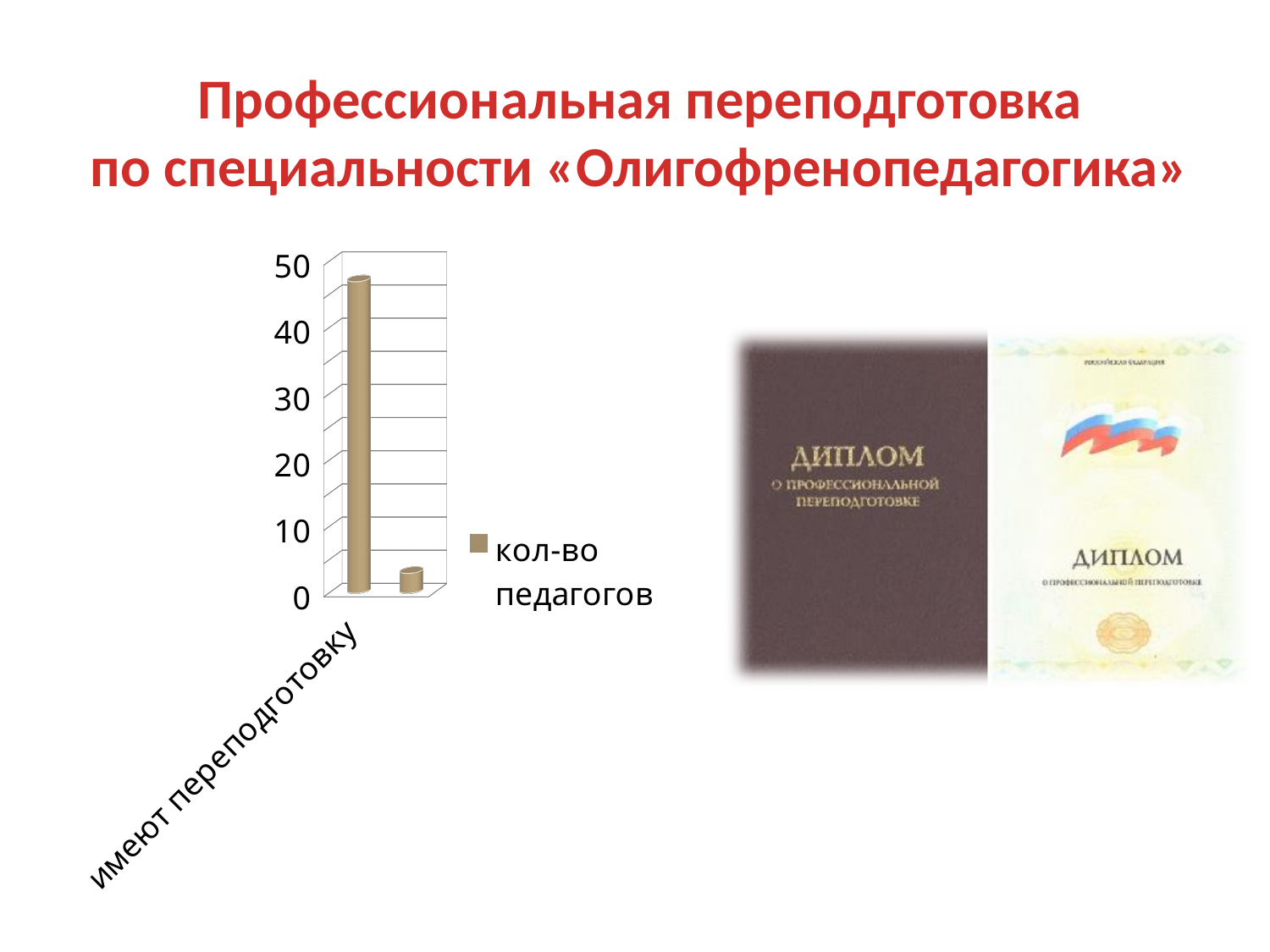
Which bar in the chart is the tallest? имеют переподготовку Is the value for "имеют переподготовку" greater or less than 40? greater How many series does the chart legend list? 1 How many bars are plotted in the chart? 2 What kind of chart is shown on the slide? bar chart What is the name of the series shown in the chart legend? кол-во педагогов Is the bar for "имеют переподготовку" taller or shorter than the other bar in the chart? taller Is the value for "имеют переподготовку" greater or less than 30? greater What is the highest value shown on the vertical axis of the chart? 50